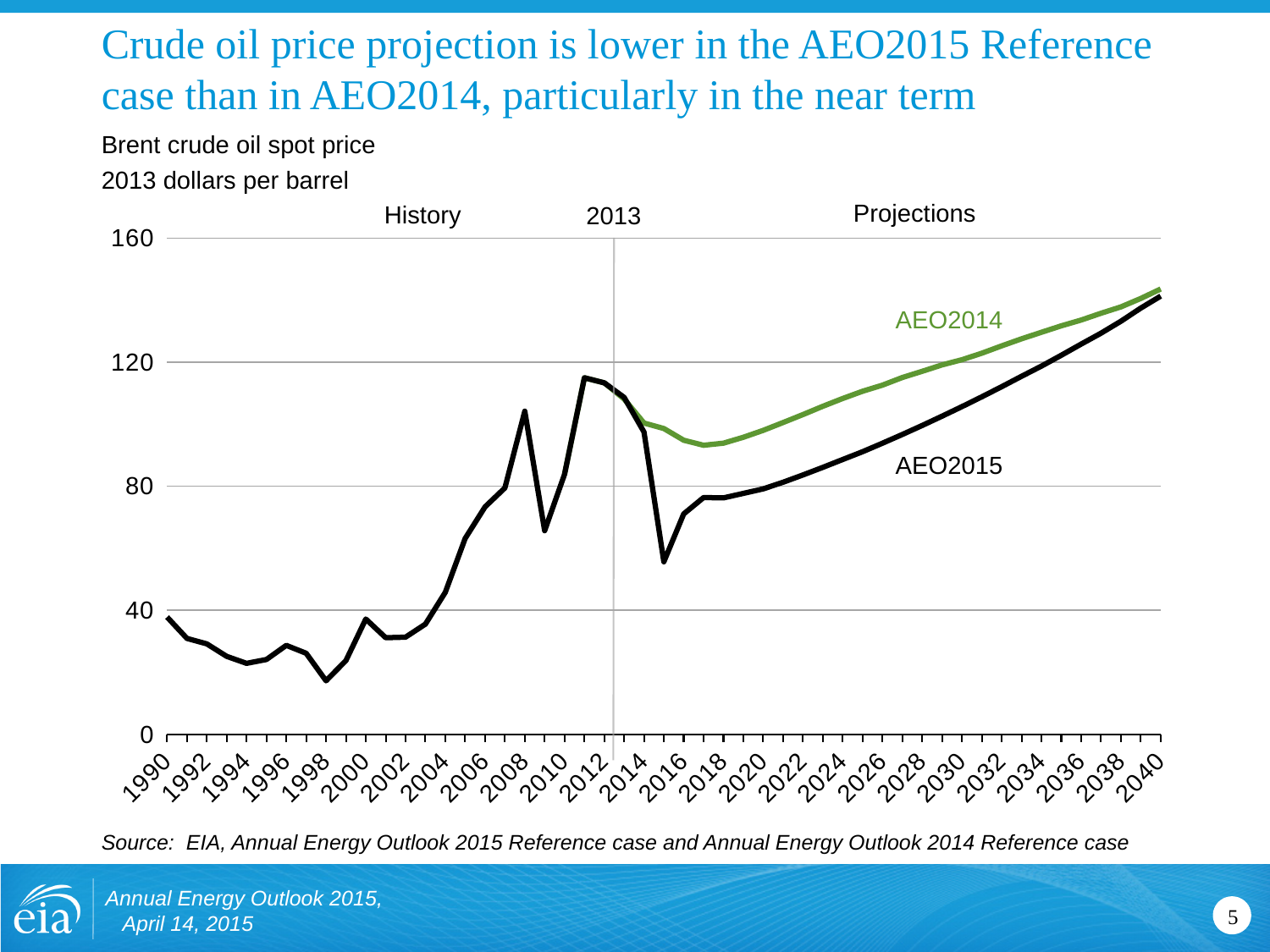
Which series has the higher value in 2020, AEO2014 or AEO2015? AEO2014 How many projection series are labeled on the chart? 2 Is the historical value for 2008 greater or less than 80? greater Is the historical value for 1998 greater or less than 40? less Is the AEO2015 value for 2030 greater or less than 120? less What kind of chart is shown on the slide? line chart In what units are the prices on the chart expressed? 2013 dollars per barrel Does the AEO2015 line rise or fall between 2020 and 2040? rise What year does the vertical line separating History from Projections mark? 2013